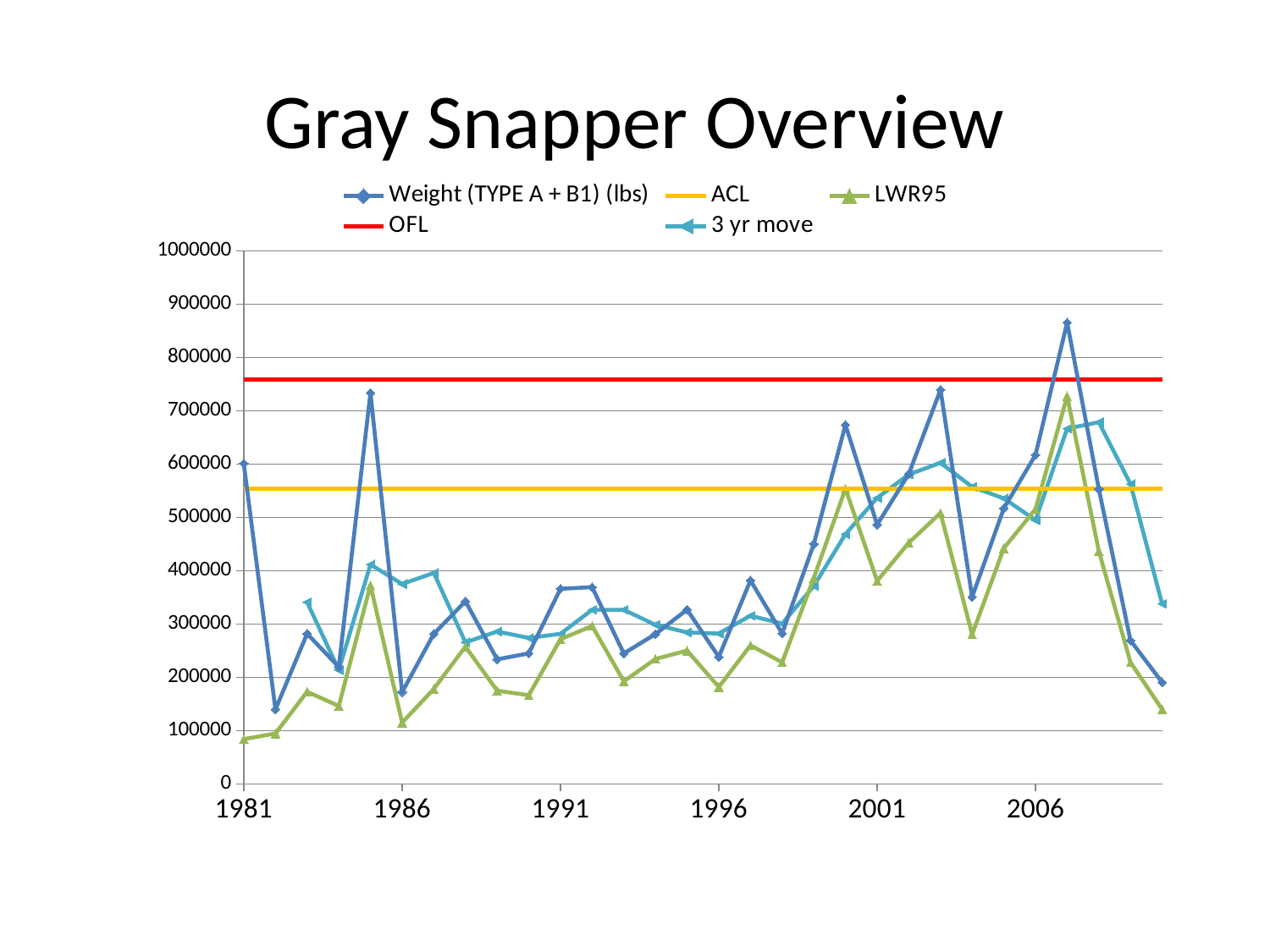
In 1985, which series has the higher value, Weight (TYPE A + B1) (lbs) or LWR95? Weight (TYPE A + B1) (lbs) Is the ACL line greater or less than 600000? less Is the LWR95 value for 1981 greater or less than 100000? less In 2007, is the Weight (TYPE A + B1) (lbs) value greater or less than the OFL line? greater Is the OFL line greater or less than 700000? greater What kind of chart is shown on the slide? line chart Does the LWR95 series rise or fall from 2007 to the last year shown? fall In which year does the Weight (TYPE A + B1) (lbs) series reach its highest value? 2007 How many series does the legend list? 5 What is the title of the chart? Gray Snapper Overview In which year is the Weight (TYPE A + B1) (lbs) series at its lowest value? 1982